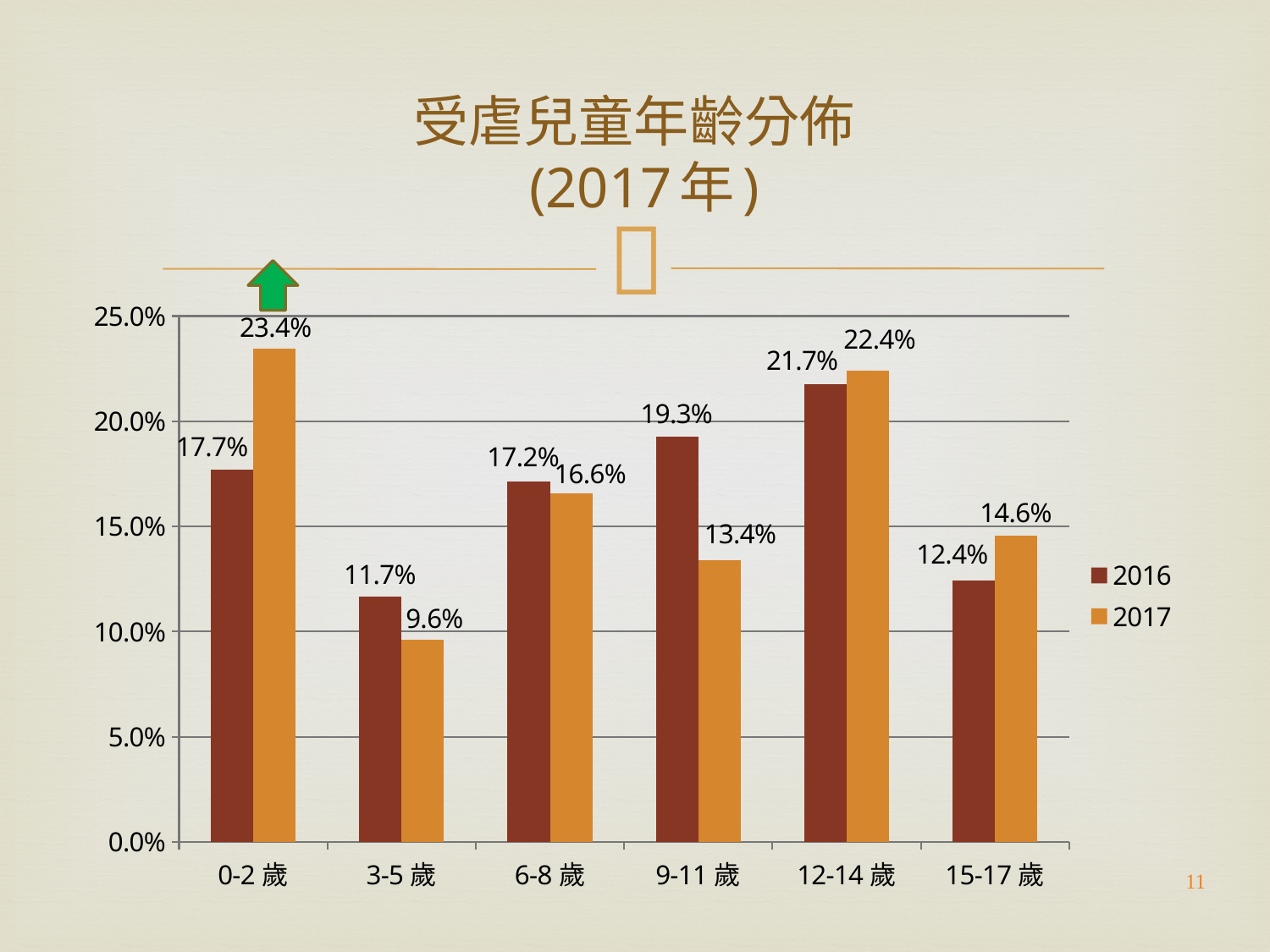
How many series does the legend list? 2 Which age group has the lowest 2017 value? 3-5 歲 What is the difference between the 2016 and 2017 values for the 9-11 歲 age group? 5.9% How many age groups are shown on the x axis? 6 What is the difference between the 2017 and 2016 values for the 0-2 歲 age group? 5.7% Which age group has the highest 2016 value? 12-14 歲 Which series is shown in orange in the legend? 2017 Which is larger for the 6-8 歲 age group, the 2016 value or the 2017 value? 2016 What is the 2017 value for the 0-2 歲 age group? 23.4% What is the 2016 value for the 9-11 歲 age group? 19.3% What kind of chart is shown on the slide? Bar chart What is the 2017 value for the 15-17 歲 age group? 14.6%